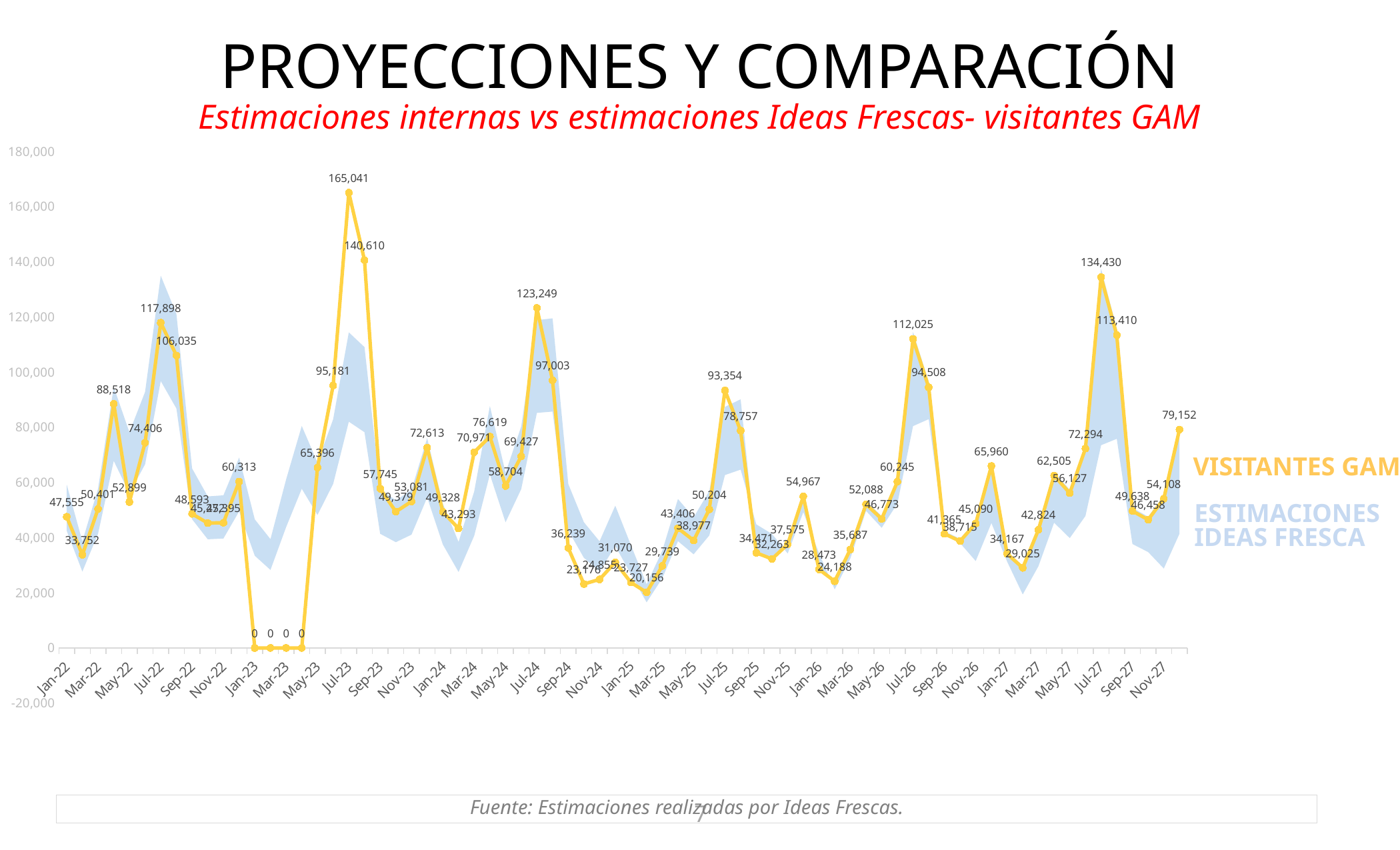
How many months show a VISITANTES GAM value of 0? 4 What is the value of VISITANTES GAM for Jul-24? 123,249 What is the value of VISITANTES GAM for Jul-22? 117,898 Is the VISITANTES GAM value for Feb-25 greater or less than 40,000? less What is the difference between the VISITANTES GAM values for Jul-23 (165,041) and Aug-23 (140,610)? 24,431 What type of chart is shown on the slide? Combination line and area chart What is the value of VISITANTES GAM for Jul-27? 134,430 Which month has the highest VISITANTES GAM value? Jul-23 What is the value of VISITANTES GAM for Jul-23? 165,041 What is the difference between the VISITANTES GAM values for Jul-27 (134,430) and Jul-26 (112,025)? 22,405 Which is larger, the VISITANTES GAM value for Jul-22 or for Jul-24? Jul-24 How many series does the legend list? 2